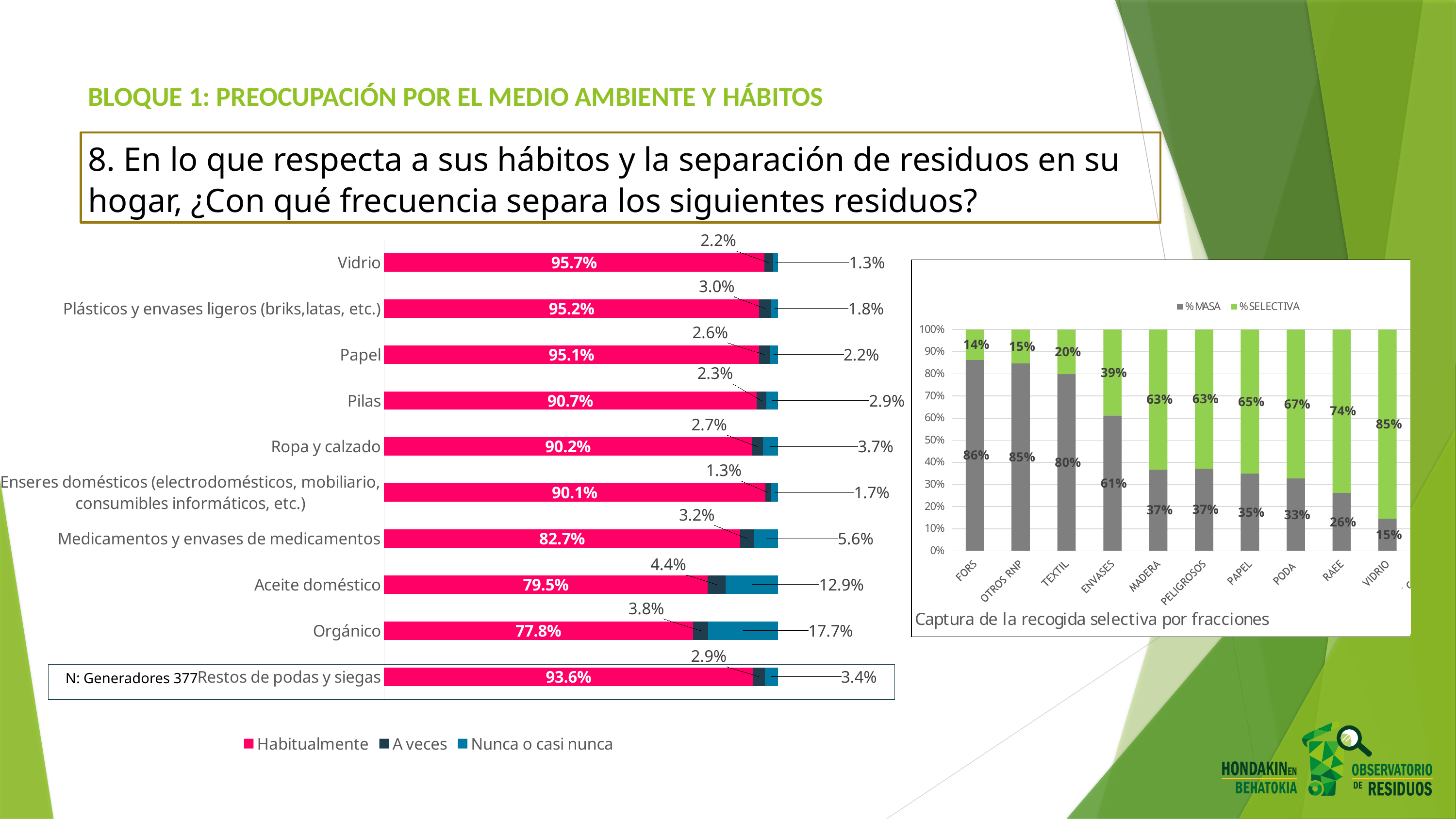
In the left chart on household waste separation habits, how many series does the legend list? 3 What type of chart is the chart titled 'Captura de la recogida selectiva por fracciones'? Stacked bar chart In the chart titled 'Captura de la recogida selectiva por fracciones', what is the % MASA value for FORS? 86% In the left chart on household waste separation habits, how many waste categories are listed? 10 In the left chart on household waste separation habits, which category has the highest 'Nunca o casi nunca' percentage? Orgánico In the left chart on household waste separation habits, what percentage of respondents separate Vidrio 'Habitualmente'? 95.7% In the left chart on household waste separation habits, what is the 'Nunca o casi nunca' value for Orgánico? 17.7% In the chart titled 'Captura de la recogida selectiva por fracciones', which of ENVASES or MADERA has the larger % SELECTIVA value? MADERA In the left chart on household waste separation habits, which category has the lowest 'Habitualmente' percentage? Orgánico In the chart titled 'Captura de la recogida selectiva por fracciones', what is the % SELECTIVA value for VIDRIO? 85% In the left chart on household waste separation habits, what is the difference between the 'Habitualmente' values for Vidrio and Aceite doméstico? 16.2% In the chart titled 'Captura de la recogida selectiva por fracciones', does the % MASA value rise or fall moving from FORS to VIDRIO along the x axis? fall